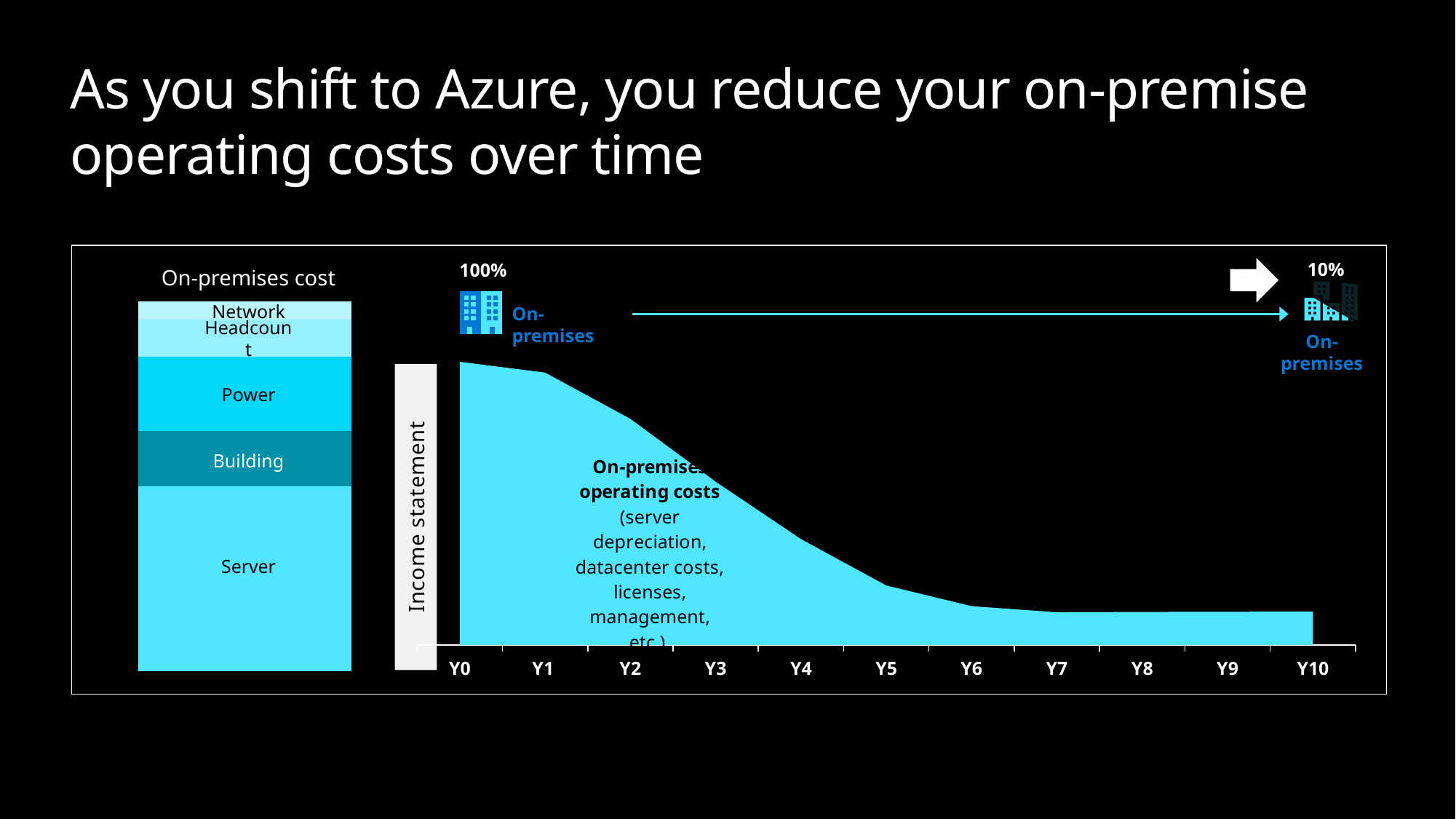
In the area chart, is the on-premises operating cost larger at Y1 or at Y6? Y1 How many cost segments are shown in the 'On-premises cost' stacked bar on the left? 5 What is the difference between the labelled starting percentage and the labelled ending percentage in the area chart? 90% In the area chart, which year has the highest on-premises operating cost? Y0 How many year categories are shown on the x axis of the area chart? 11 In the 'On-premises cost' stacked bar, which segment is the smallest? Network What kind of chart is the main chart showing on-premises operating costs from Y0 to Y10? Area chart What is the label on the vertical axis of the area chart? Income statement In the 'On-premises cost' stacked bar, which segment is the largest? Server Do the on-premises operating costs rise or fall from Y0 to Y10 in the area chart? Fall What percentage is labelled for on-premises cost at the start (Y0) of the area chart? 100% What percentage is labelled for on-premises cost at the end (Y10) of the area chart? 10%